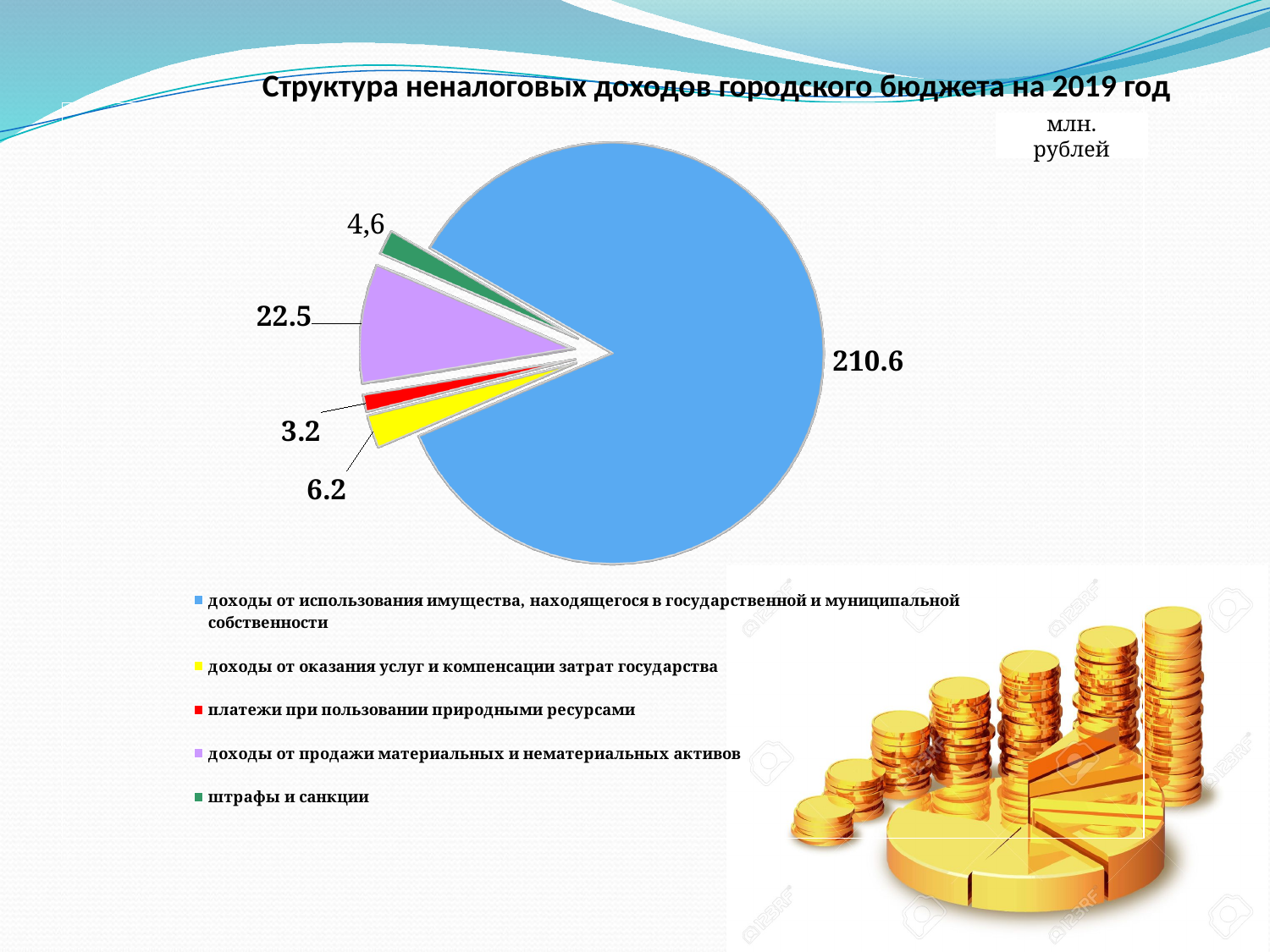
Which category has the smallest slice of the pie? платежи при пользовании природными ресурсами How many categories does the legend list? 5 What type of chart is shown on the slide? pie chart In what units are the values on the chart expressed? млн. рублей What is the value for доходы от использования имущества, находящегося в государственной и муниципальной собственности? 210.6 Which is larger: доходы от оказания услуг и компенсации затрат государства or штрафы и санкции? доходы от оказания услуг и компенсации затрат государства What is the value for доходы от продажи материальных и нематериальных активов? 22.5 What is the value for доходы от оказания услуг и компенсации затрат государства? 6.2 What is the value for штрафы и санкции? 4,6 What is the value for платежи при пользовании природными ресурсами? 3.2 What is the difference between доходы от продажи материальных и нематериальных активов and доходы от оказания услуг и компенсации затрат государства? 16.3 Which category has the largest slice of the pie? доходы от использования имущества, находящегося в государственной и муниципальной собственности